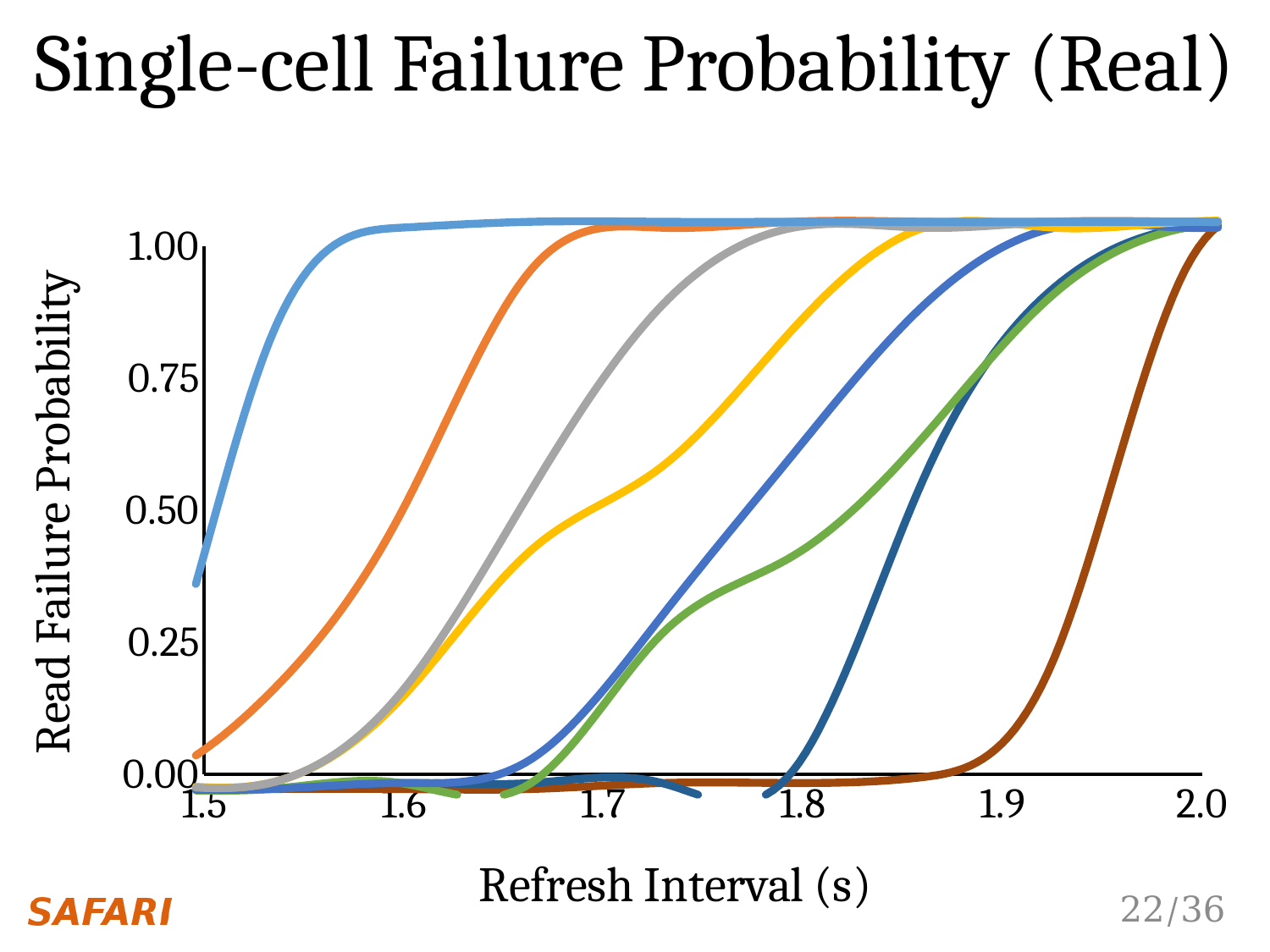
Is the value of the brown line at a refresh interval of 1.9 s greater or less than 0.50? less Is the value of the gray line at a refresh interval of 1.8 s greater or less than 0.75? greater At a refresh interval of 1.7 s, which line has the higher read failure probability, the orange line or the brown line? orange line What kind of chart is shown on the slide? line chart What is the title of the chart? Single-cell Failure Probability (Real) Is the value of the orange line at a refresh interval of 1.7 s greater or less than 0.75? greater What is the label of the x axis? Refresh Interval (s) How many lines are plotted on the chart? 8 Do the plotted lines rise or fall as the refresh interval increases along the x axis? rise